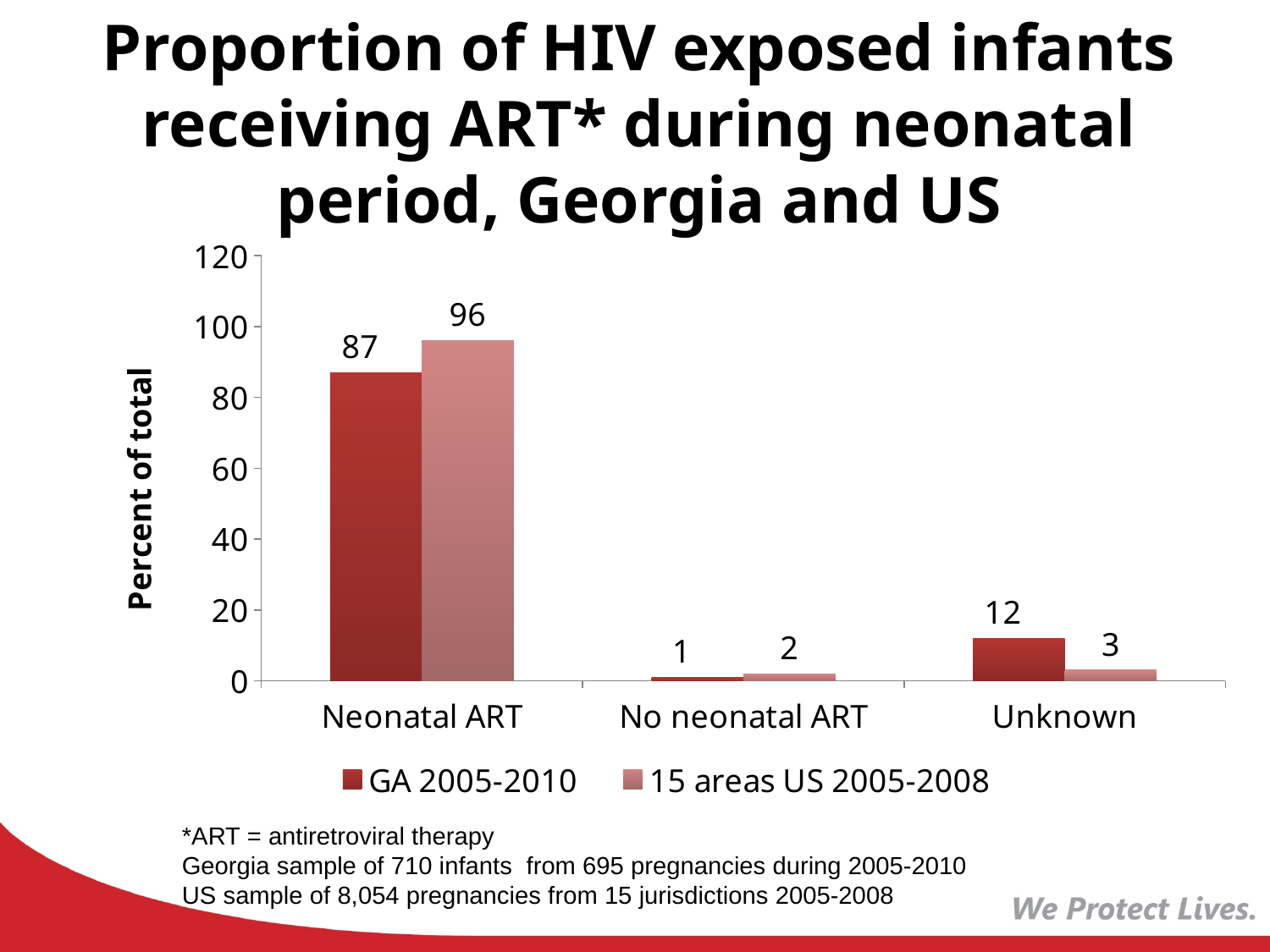
In the Unknown category, which series has the larger value, GA 2005-2010 or 15 areas US 2005-2008? GA 2005-2010 What is the label of the y axis? Percent of total What is the value for GA 2005-2010 in the Neonatal ART category? 87 How many series does the legend list? 2 Which category has the highest value for GA 2005-2010? Neonatal ART What is the value for 15 areas US 2005-2008 in the No neonatal ART category? 2 What is the difference between the 15 areas US 2005-2008 and GA 2005-2010 values in the Neonatal ART category? 9 What is the value for 15 areas US 2005-2008 in the Neonatal ART category? 96 What is the value for GA 2005-2010 in the Unknown category? 12 How many categories are shown on the x axis? 3 Which category has the lowest value for 15 areas US 2005-2008? No neonatal ART What kind of chart is shown on the slide? Bar chart